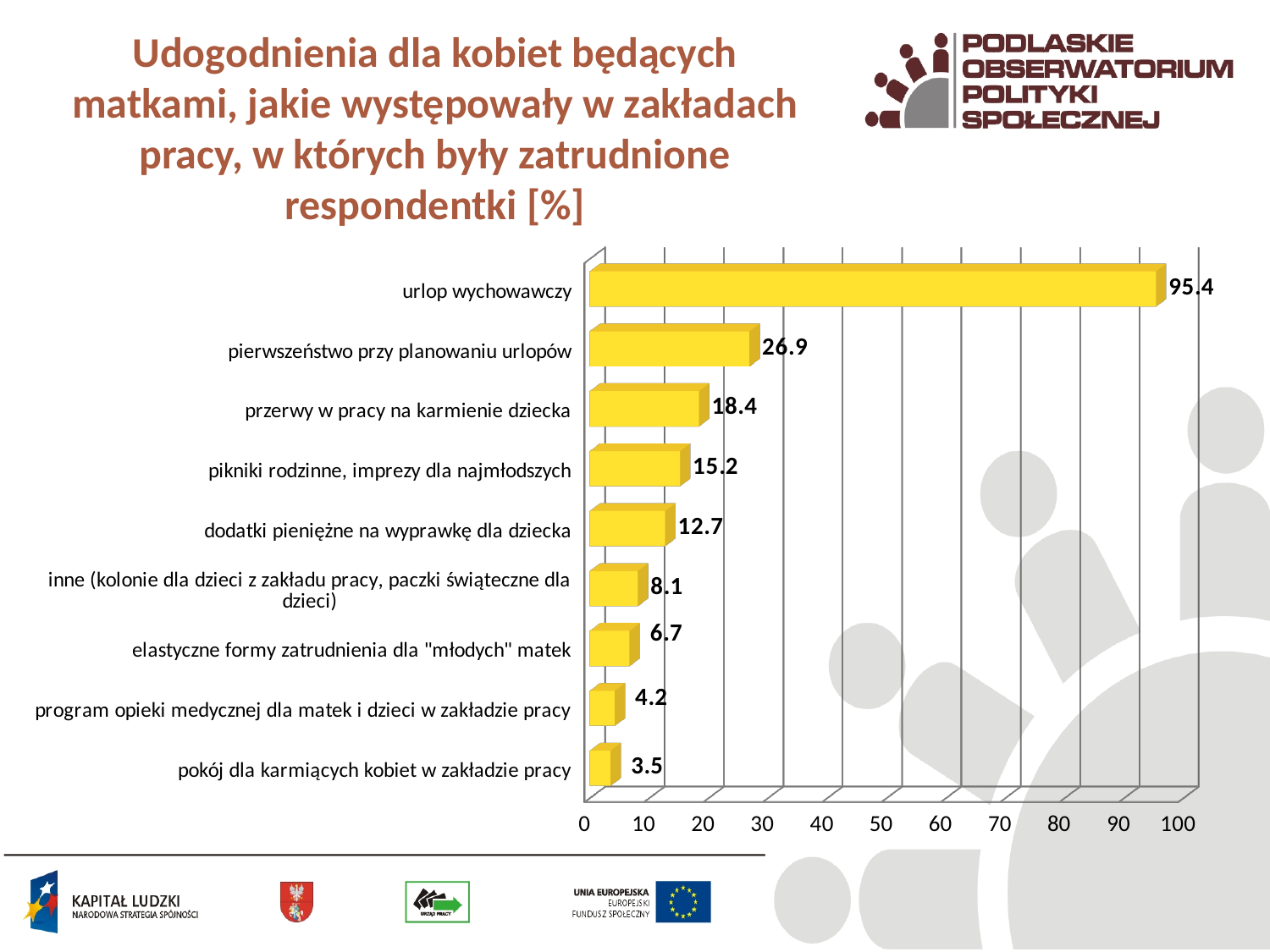
What is the value for "pokój dla karmiących kobiet w zakładzie pracy"? 3.5 Which category has the lowest value? pokój dla karmiących kobiet w zakładzie pracy Is the value for "pierwszeństwo przy planowaniu urlopów" greater or less than 20? greater What is the value for "urlop wychowawczy"? 95.4 Which is larger: the value for "pikniki rodzinne, imprezy dla najmłodszych" or for "dodatki pieniężne na wyprawkę dla dziecka"? pikniki rodzinne, imprezy dla najmłodszych What is the value for "przerwy w pracy na karmienie dziecka"? 18.4 How many categories are shown in the chart? 9 What is the highest tick value shown on the horizontal axis? 100 What is the value for "elastyczne formy zatrudnienia dla "młodych" matek"? 6.7 What kind of chart is shown on the slide? bar chart Which category has the highest value? urlop wychowawczy What is the difference between the values for "urlop wychowawczy" and "pierwszeństwo przy planowaniu urlopów"? 68.5